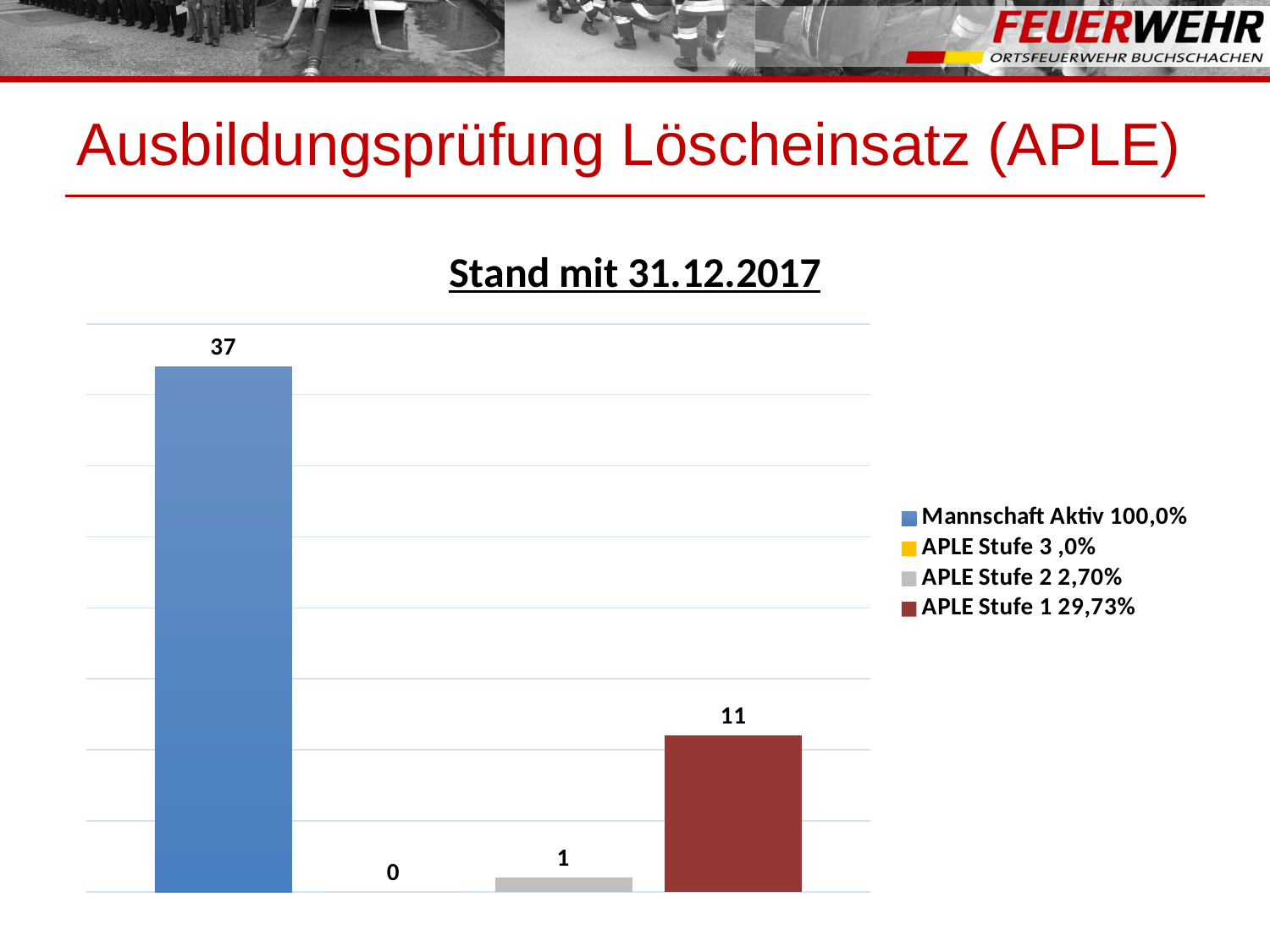
What kind of chart is shown on the slide? Bar chart Which series has the lowest value? APLE Stufe 3 What is the title of the chart? Stand mit 31.12.2017 What is the difference between the values for Mannschaft Aktiv and APLE Stufe 1? 26 What is the value for APLE Stufe 3? 0 Which is larger, the value for APLE Stufe 1 or the value for APLE Stufe 2? APLE Stufe 1 What is the value for APLE Stufe 2? 1 What is the value for APLE Stufe 1? 11 What is the value for Mannschaft Aktiv? 37 How many series does the legend list? 4 Which series has the highest value? Mannschaft Aktiv